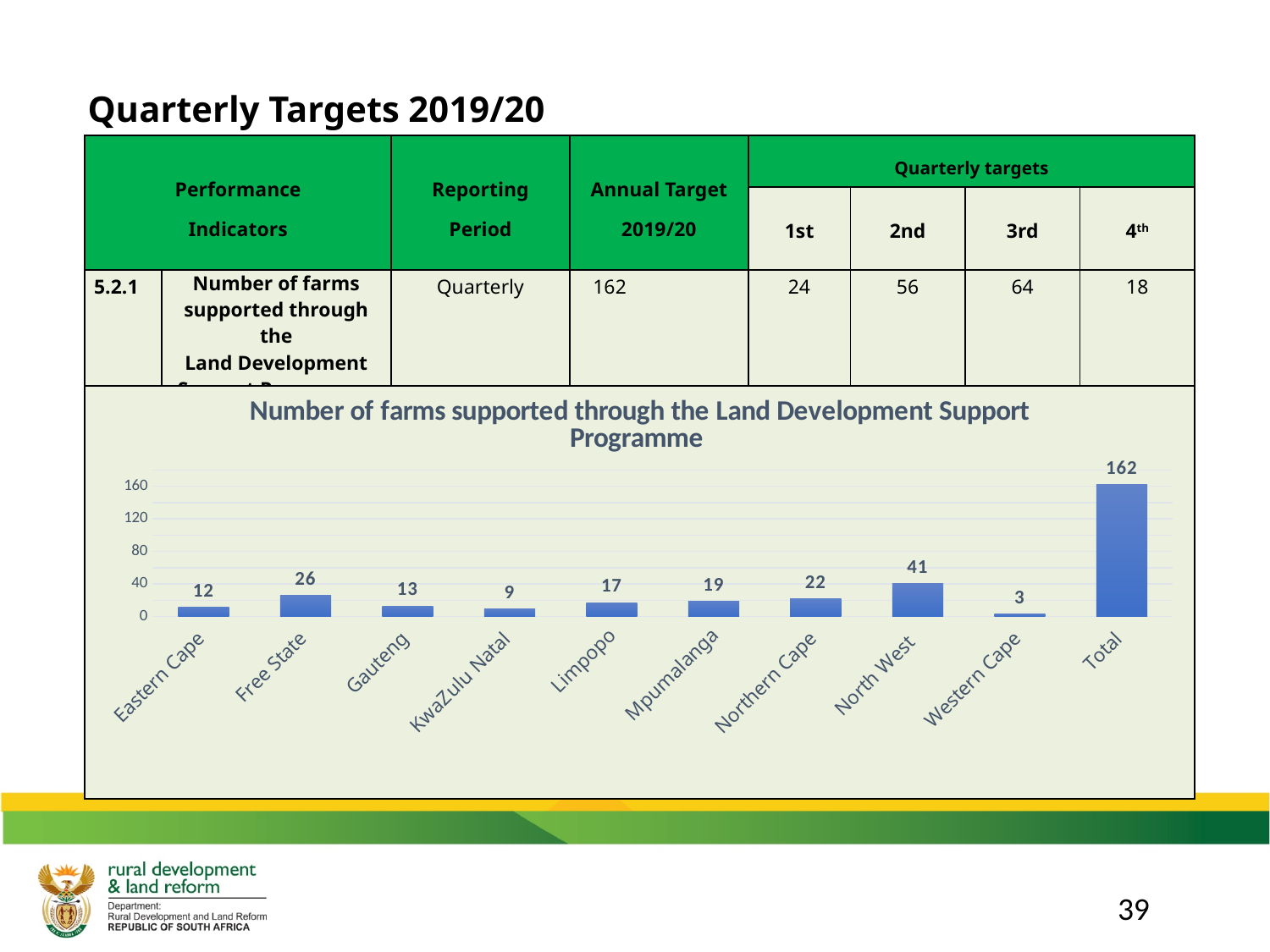
Which is larger, the value for Limpopo or the value for Mpumalanga? Mpumalanga Is the value for the Total bar greater or less than 120? greater What is the title of the chart? Number of farms supported through the Land Development Support Programme What is the value for KwaZulu Natal in the chart? 9 What is the difference between the values for North West and Northern Cape? 19 What is the value for Gauteng in the chart? 13 What kind of chart is shown on the slide? Bar chart What is the value for North West in the chart? 41 Which province has the lowest value in the chart? Western Cape What is the value for Free State in the chart? 26 Excluding the Total bar, which province has the highest value in the chart? North West How many bars are shown in the chart, including the Total bar? 10